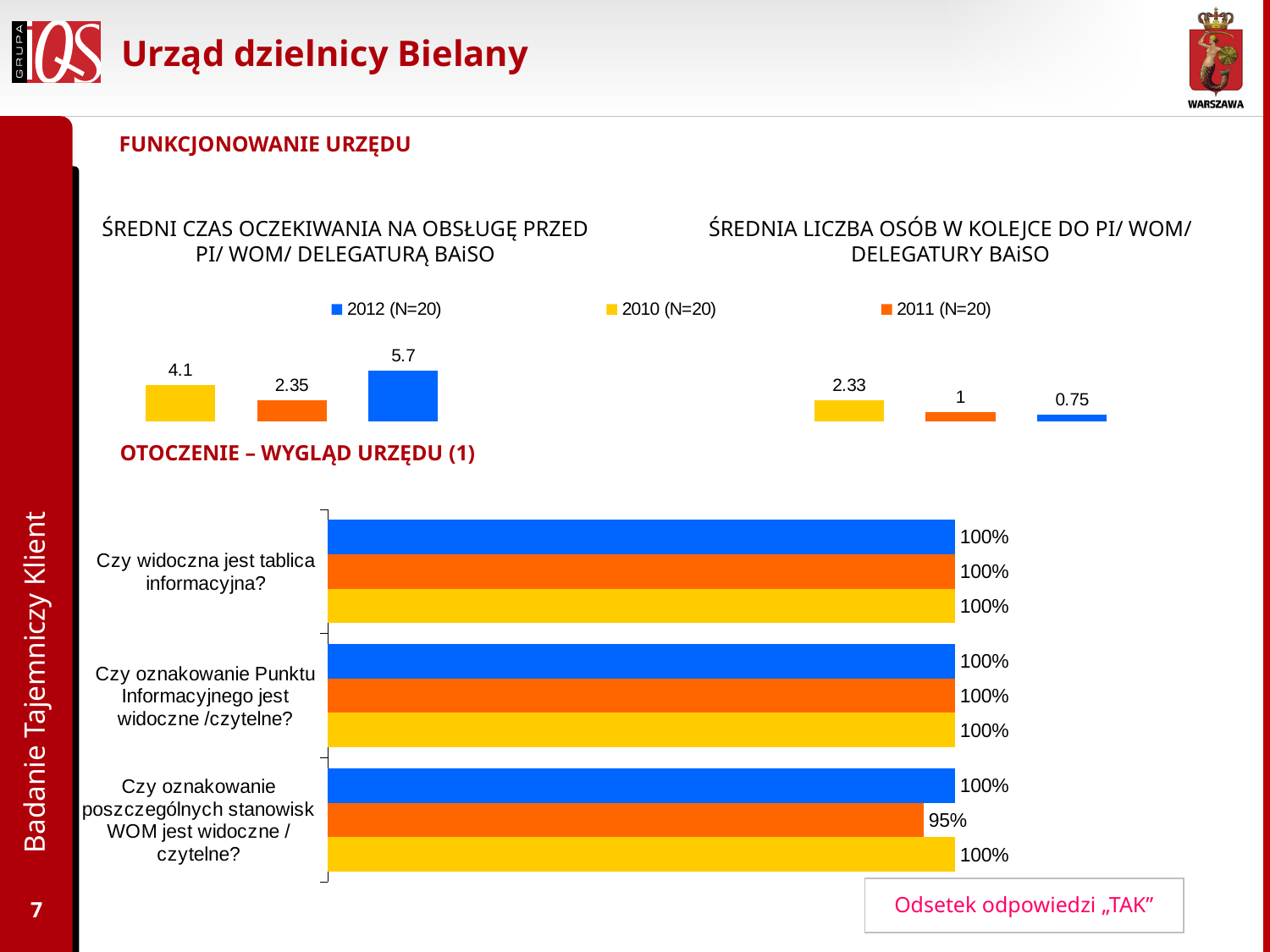
In the chart titled 'ŚREDNIA LICZBA OSÓB W KOLEJCE DO PI/ WOM/ DELEGATURY BAiSO', which year has the lowest value? 2012 (N=20) In the bottom chart under 'OTOCZENIE – WYGLĄD URZĘDU (1)', what is the 2012 (blue) value for 'Czy widoczna jest tablica informacyjna?'? 100% In the chart titled 'ŚREDNI CZAS OCZEKIWANIA NA OBSŁUGĘ PRZED PI/ WOM/ DELEGATURĄ BAiSO', what is the value for 2011 (N=20)? 2.35 In the chart titled 'ŚREDNI CZAS OCZEKIWANIA NA OBSŁUGĘ PRZED PI/ WOM/ DELEGATURĄ BAiSO', what is the value for 2012 (N=20)? 5.7 In the bottom chart under 'OTOCZENIE – WYGLĄD URZĘDU (1)', what is the 2011 (orange) value for 'Czy oznakowanie poszczególnych stanowisk WOM jest widoczne / czytelne?'? 95% In the chart titled 'ŚREDNI CZAS OCZEKIWANIA NA OBSŁUGĘ PRZED PI/ WOM/ DELEGATURĄ BAiSO', what is the difference between the 2012 and 2010 values? 1.6 How many series does the legend above the top charts list? 3 What type of chart is the bottom chart under 'OTOCZENIE – WYGLĄD URZĘDU (1)'? Bar chart In the chart titled 'ŚREDNIA LICZBA OSÓB W KOLEJCE DO PI/ WOM/ DELEGATURY BAiSO', which is larger: the value for 2011 or the value for 2012? 2011 How many question categories are shown in the bottom chart under 'OTOCZENIE – WYGLĄD URZĘDU (1)'? 3 In the chart titled 'ŚREDNIA LICZBA OSÓB W KOLEJCE DO PI/ WOM/ DELEGATURY BAiSO', what is the value for 2010 (N=20)? 2.33 In the chart titled 'ŚREDNI CZAS OCZEKIWANIA NA OBSŁUGĘ PRZED PI/ WOM/ DELEGATURĄ BAiSO', which year has the highest value? 2012 (N=20)